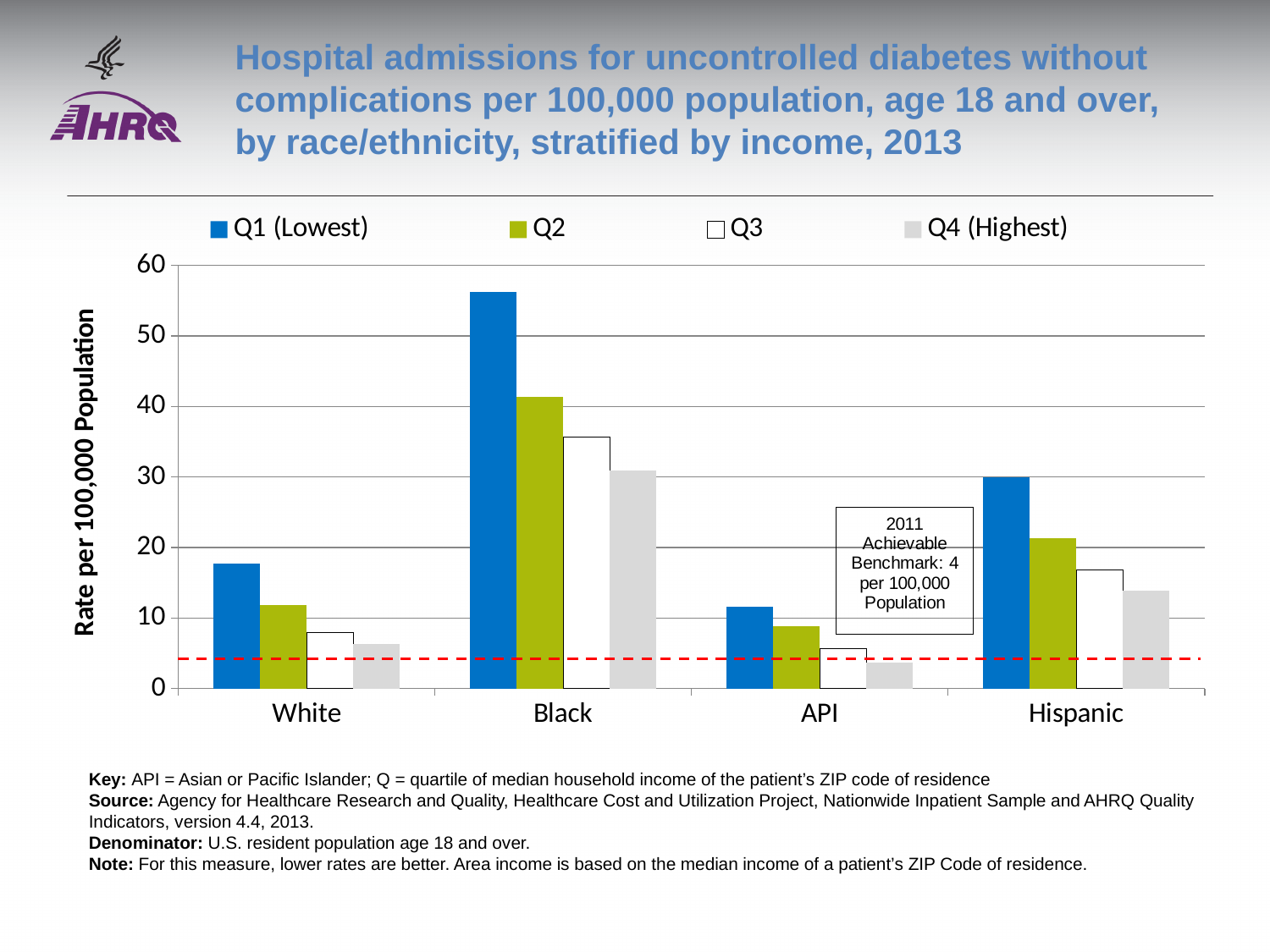
Is the Q2 value for Hispanic greater or less than 20? greater How many series does the legend list? 4 What kind of chart is shown on the slide? bar chart Which race/ethnicity group has the highest Q1 (Lowest) rate? Black Is the Q3 value for Black greater or less than 40? less How many race/ethnicity categories are shown on the x axis? 4 Which is larger, the Q1 (Lowest) value for Hispanic or the Q1 (Lowest) value for White? Hispanic Is the Q4 (Highest) value for White greater or less than 10? less What is the 2011 Achievable Benchmark value shown on the chart? 4 per 100,000 Population Which race/ethnicity group has the lowest Q4 (Highest) rate? API Within the Black group, do the values rise or fall from Q1 (Lowest) to Q4 (Highest)? fall